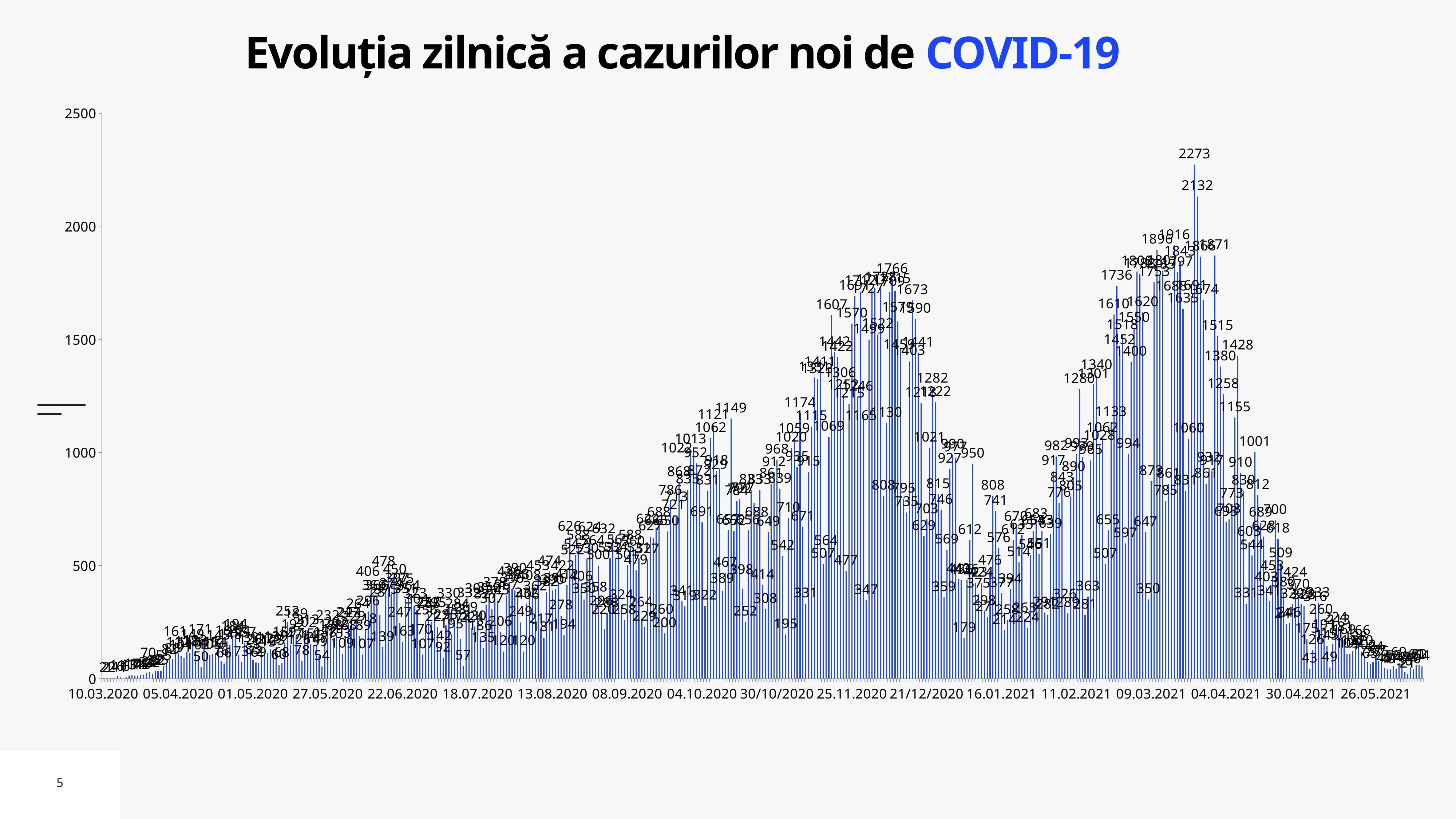
What is the second-highest data label shown on the chart, next to the 2273 peak? 2132 Are the bars at the far right end of the chart (after 26.05.2021) rising or falling? falling What is the highest daily value shown on the chart? 2273 Is the highest bar on the chart greater or less than 2000? greater What kind of chart is shown on the slide? bar chart Is the peak of the wave around 25.11.2020 greater or less than 2000? less Which is larger, the bar labelled 2273 or the bar labelled 2132? 2273 What is the difference between the two highest labelled values, 2273 and 2132? 141 Is the peak of the wave around 04.04.2021 greater or less than 2000? greater What is the title of the chart? Evoluția zilnică a cazurilor noi de COVID-19 What is the highest value shown on the vertical axis? 2500